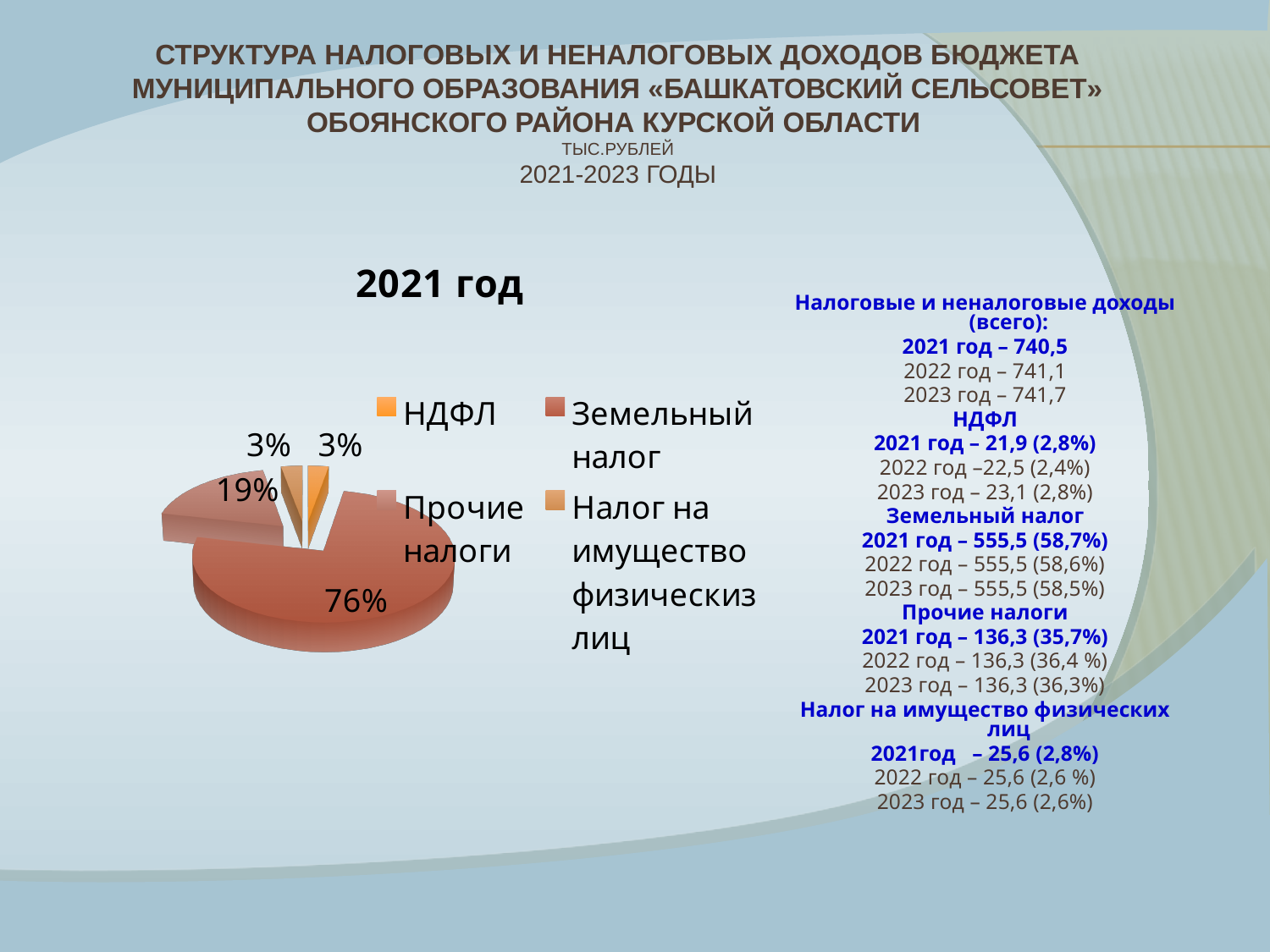
What is the title of the pie chart? 2021 год Which legend entry is shown in dark red in the pie chart? Земельный налог What share of the pie does Налог на имущество физических лиц have? 3% What share of the pie does Земельный налог have? 76% Which category has the largest slice in the pie chart? Земельный налог How many entries does the legend of the pie chart list? 4 What share of the pie does НДФЛ have? 3% What kind of chart is shown on the slide? pie chart What is the difference in percentage points between the Земельный налог slice and the Прочие налоги slice? 57 How many slices does the pie chart have? 4 Which is larger in the pie chart, Прочие налоги or НДФЛ? Прочие налоги